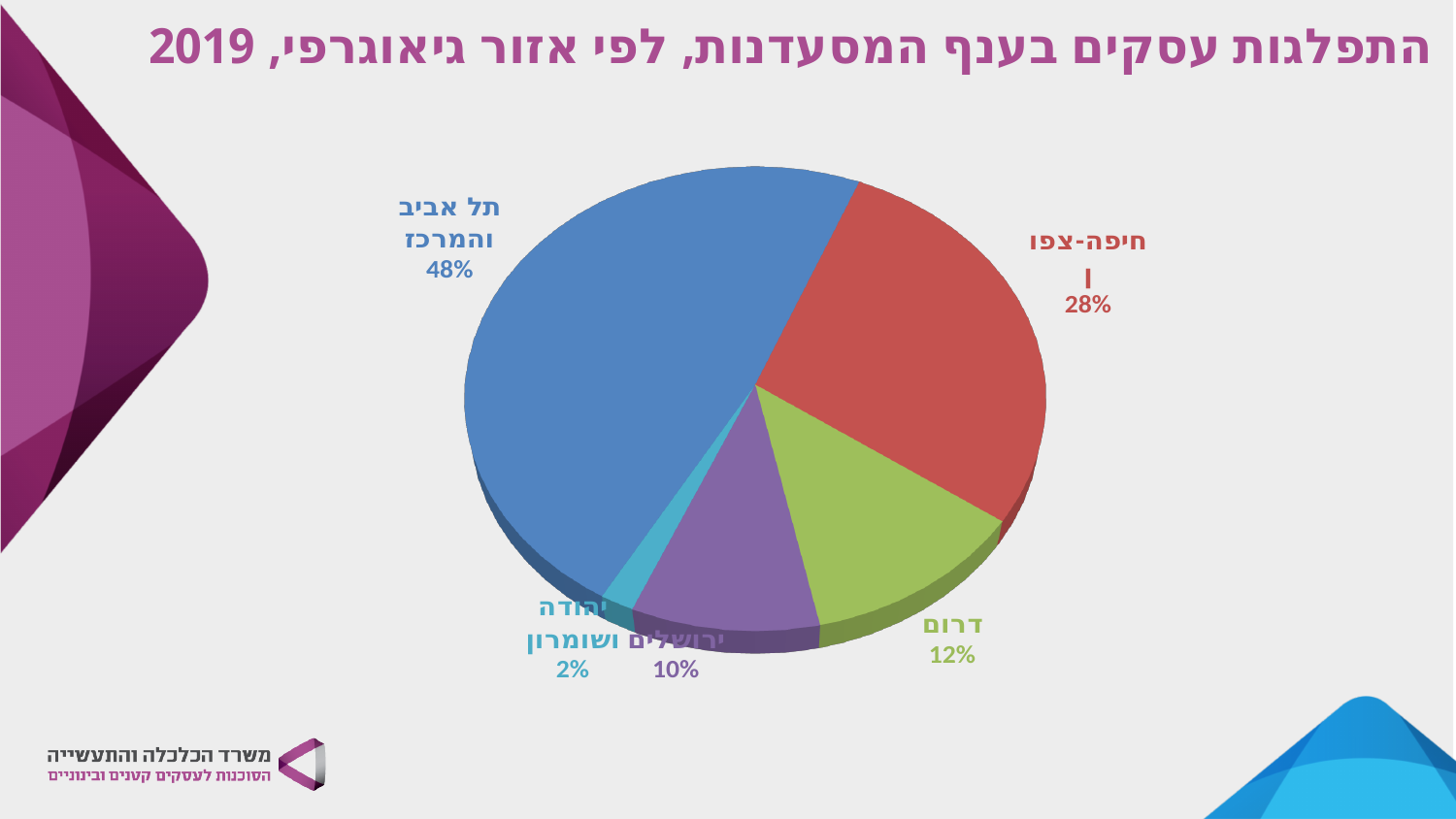
What percentage is shown for חיפה-צפון? 28% What share of the pie does תל אביב והמרכז hold? 48% How many slices does the pie chart have? 5 What type of chart is shown on the slide? Pie chart What is the difference in percentage points between תל אביב והמרכז and חיפה-צפון? 20 Which region has the largest slice of the pie? תל אביב והמרכז What colour is the slice for חיפה-צפון? Red What percentage is shown for ירושלים? 10% What is the value labelled for דרום? 12% What share is shown for יהודה ושומרון? 2% Which region has the smallest slice of the pie? יהודה ושומרון Which is larger, the share for דרום or the share for ירושלים? דרום